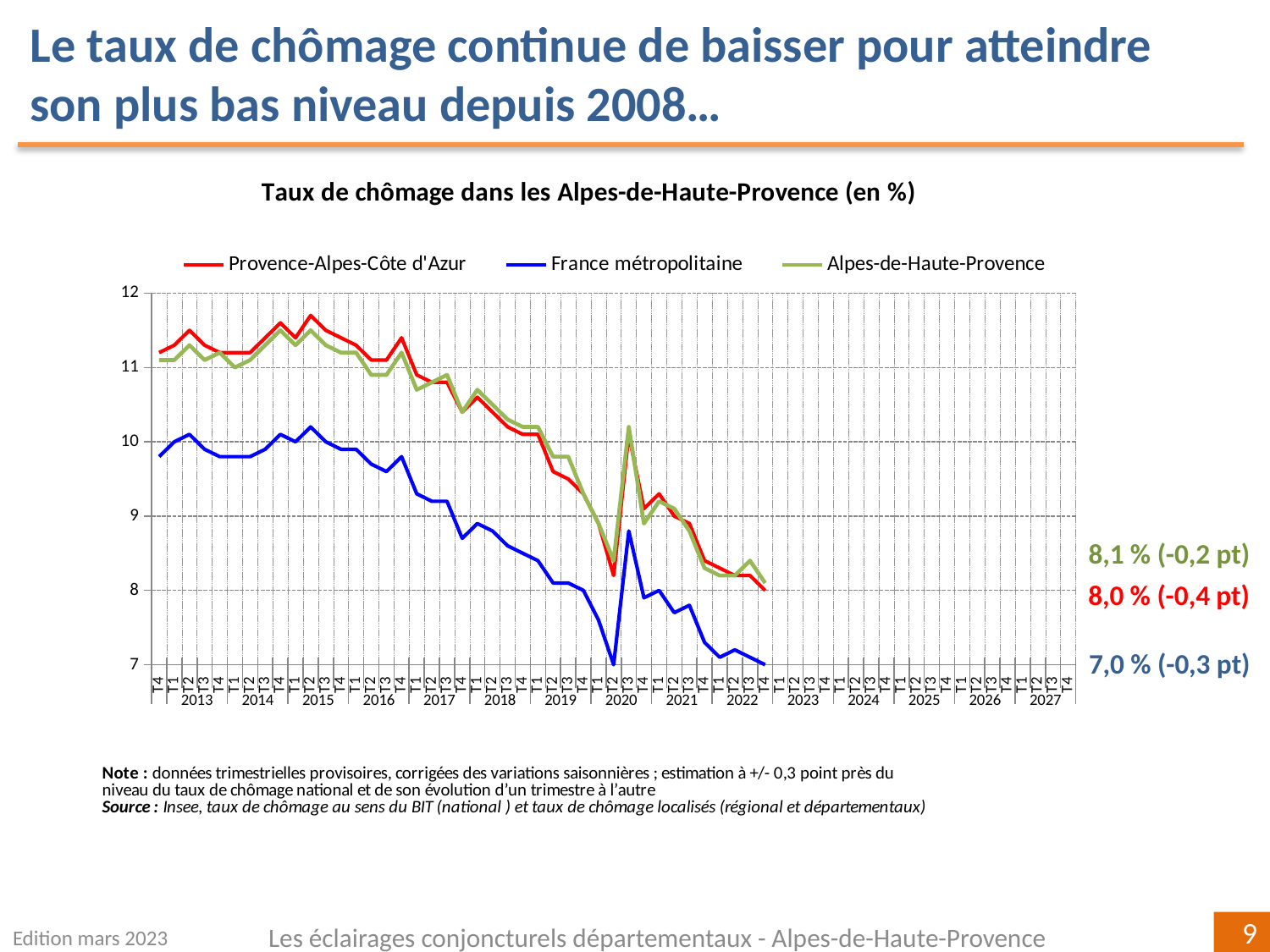
What is the latest unemployment rate shown for Alpes-de-Haute-Provence? 8,1 % Overall, do the unemployment rates rise or fall from 2013 to 2022? fall At the latest point, which is higher: Provence-Alpes-Côte d'Azur or France métropolitaine? Provence-Alpes-Côte d'Azur Is the value for Provence-Alpes-Côte d'Azur in T2 2015 greater or less than 11? greater What is the difference between the latest values for Alpes-de-Haute-Provence and France métropolitaine? 1,1 points Which series has the lowest value at the end of the chart? France métropolitaine What is the latest unemployment rate shown for France métropolitaine? 7,0 % How many series does the legend list? 3 What quarterly change is shown next to the latest value for France métropolitaine? -0,3 pt What kind of chart is shown on the slide? line chart What is the latest unemployment rate shown for Provence-Alpes-Côte d'Azur? 8,0 % Is the value for France métropolitaine in T1 2020 greater or less than 8? less